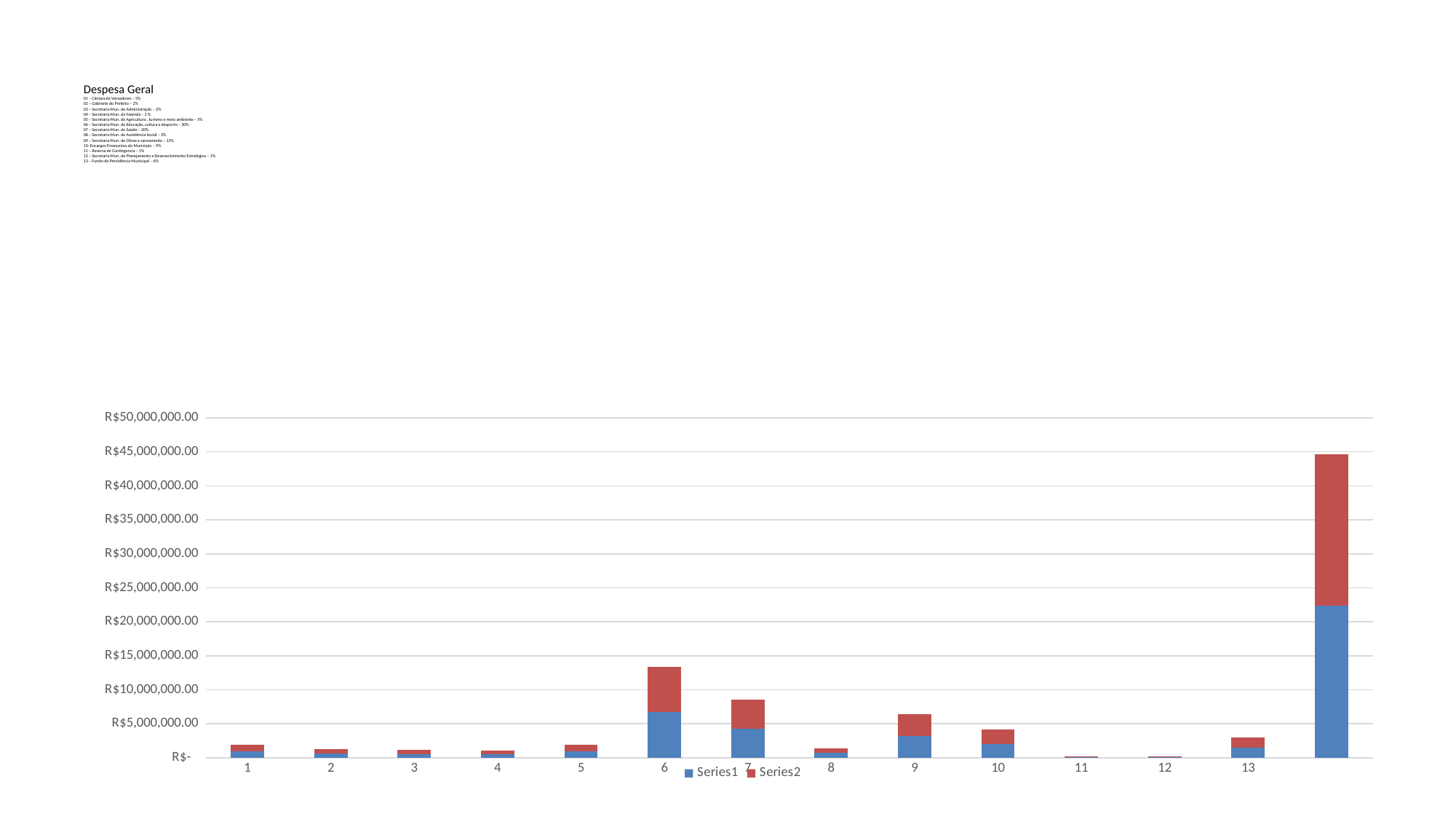
Is the total of the rightmost (unlabelled) stacked bar greater or less than R$40,000,000.00? greater How many series does the legend list? 2 What kind of chart is shown on the slide? stacked bar chart What are the two series names shown in the legend? Series1 and Series2 Is the total of the stacked bar for category 10 greater or less than R$5,000,000.00? less Which has the larger stacked total, category 9 or category 10? 9 Among the categories labelled 1 to 13, which has the tallest stacked bar? 6 Is the total of the stacked bar for category 7 greater or less than R$10,000,000.00? less Which has the larger stacked total, category 6 or category 7? 6 Which colour represents Series2 in the chart? red